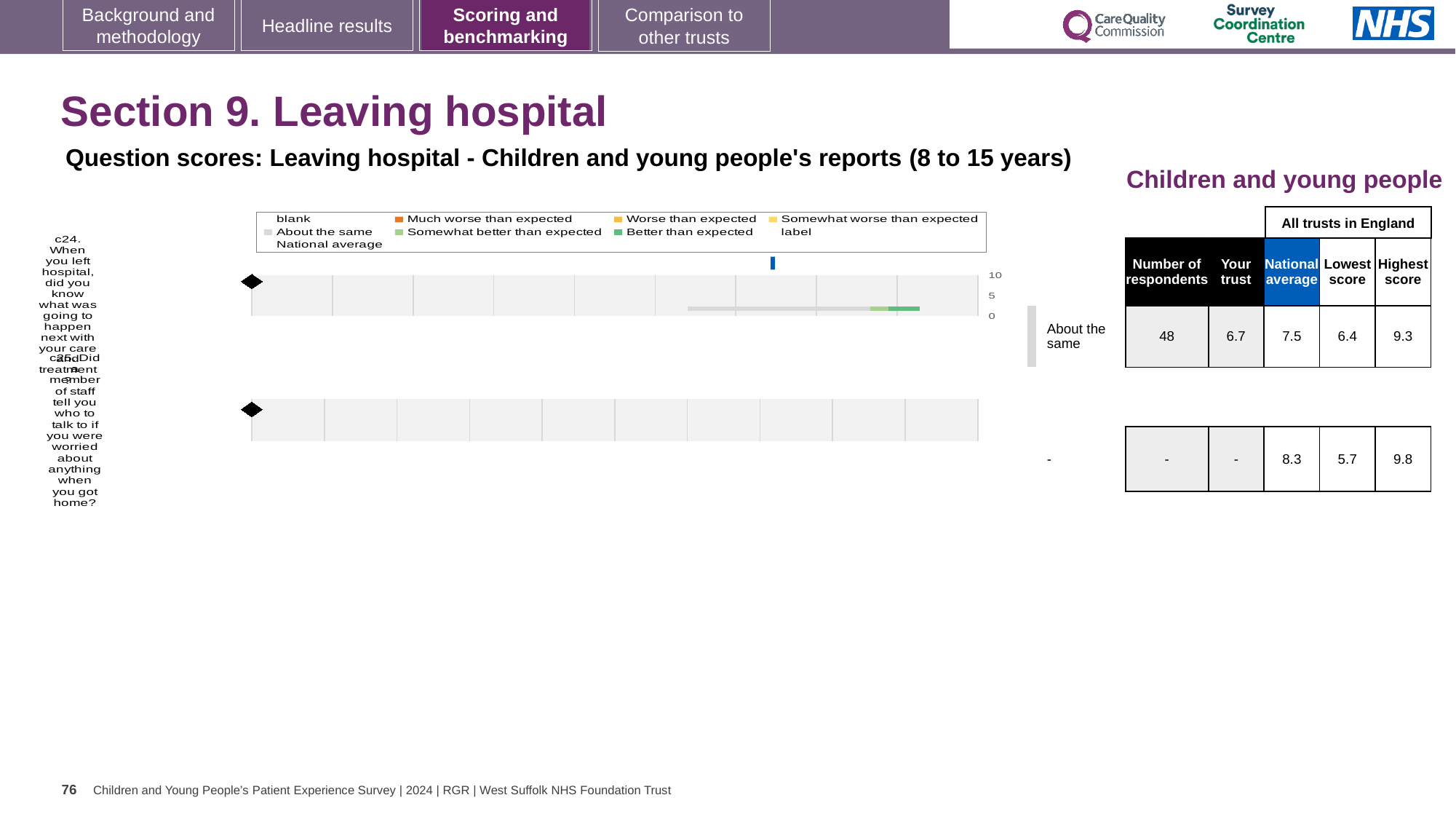
What is the lowest score among all trusts in England for question c25? 5.7 How many entries does the legend of the Leaving hospital chart list? 9 What is the national average score for question c24? 7.5 How many respondents answered question c24? 48 Which is larger for question c24: the 'Your trust' score or the national average? National average How many questions (rows) are plotted in the Leaving hospital chart? 2 What benchmark category is shown for question c24 in the Leaving hospital chart? About the same What is the difference between the national average and the 'Your trust' score for question c24? 0.8 What is the highest score among all trusts in England for question c24? 9.3 What is the 'Your trust' score for question c24 (When you left hospital, did you know what was going to happen next with your care and treatment)? 6.7 What is the national average score for question c25 (Did a member of staff tell you who to talk to if you were worried about anything when you got home)? 8.3 What kind of chart is shown on the slide for the Leaving hospital question scores? bar chart